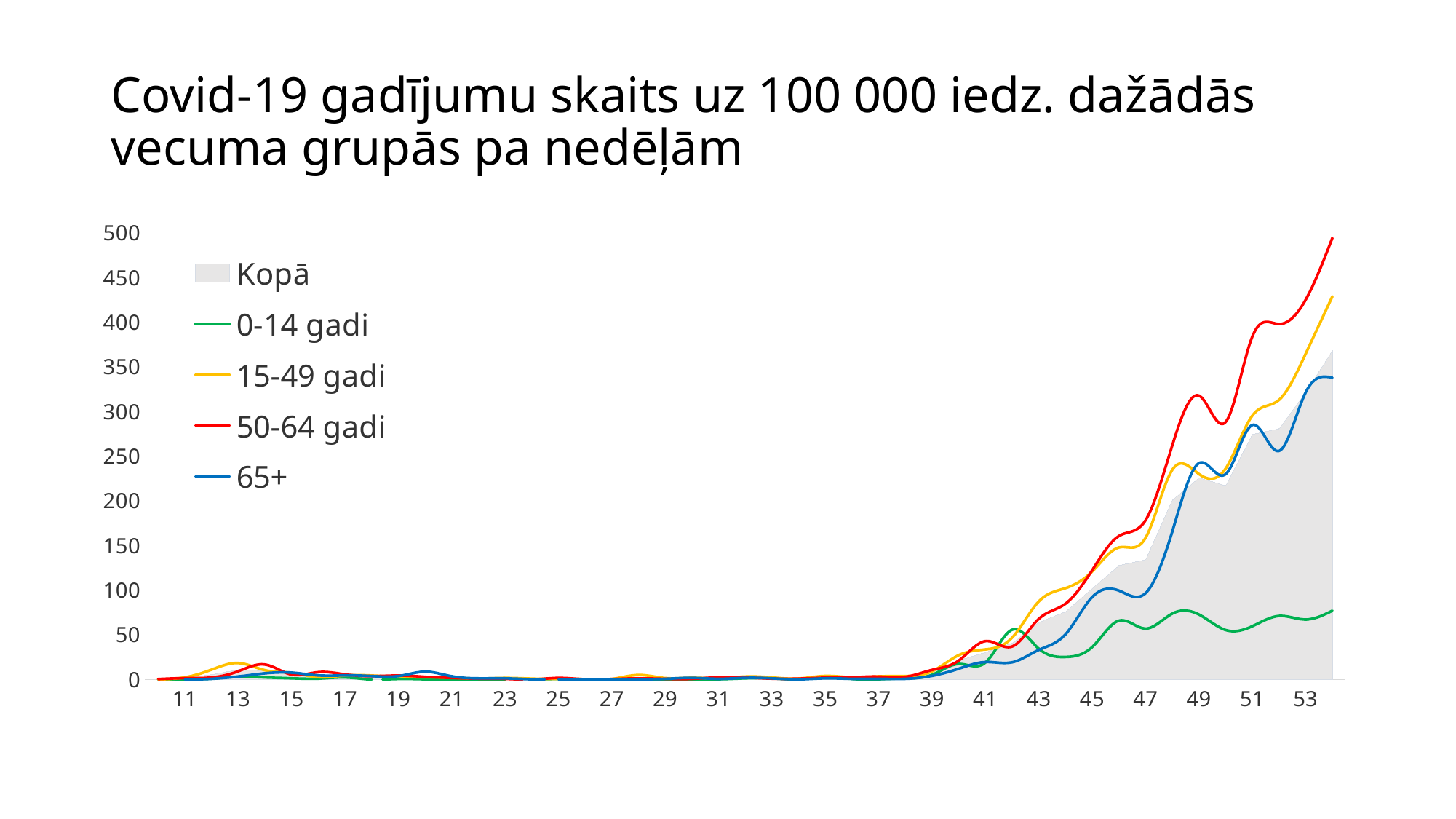
At week 49, which is larger: the value for 0-14 gadi or the value for 65+? 65+ Is the value for 65+ at the last week shown greater or less than 300? greater What kind of chart is shown on the slide? combination area and line chart Is the value for 50-64 gadi at the last week shown greater or less than 450? greater Which age group has the lowest value at the last week shown (week 54)? 0-14 gadi Is the value for 15-49 gadi at the last week shown greater or less than 400? greater Do the values for 50-64 gadi generally rise or fall from week 39 to week 54? rise How many series does the legend list? 5 At the last week shown, which is larger: the value for 50-64 gadi or the value for 65+? 50-64 gadi Which age group has the highest value at the last week shown (week 54)? 50-64 gadi Which series is drawn as a shaded grey area rather than a line? Kopā